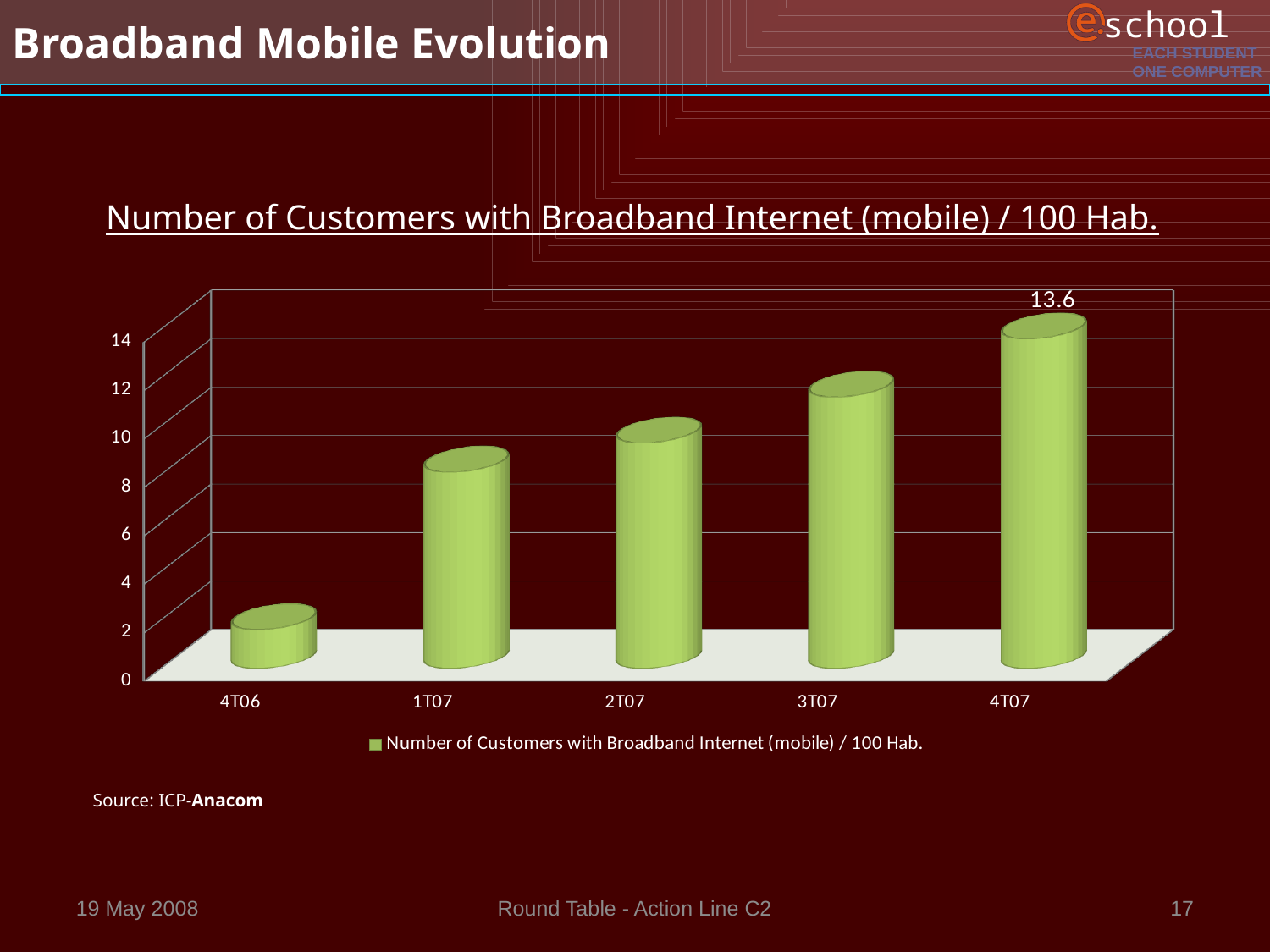
What kind of chart is shown on the slide? Bar chart Which quarter has the highest number of customers with broadband internet (mobile) per 100 Hab.? 4T07 Is the value for 1T07 greater or less than 6? greater Do the values rise or fall from 4T06 to 4T07? Rise What is the value for 4T07? 13.6 How many quarters are shown on the x axis? 5 Which quarter has the lowest value? 4T06 How many series does the legend list? 1 Is the value for 4T06 greater or less than 4? less Is the value for 3T07 greater or less than 10? greater Which is larger, the value for 1T07 or the value for 3T07? 3T07